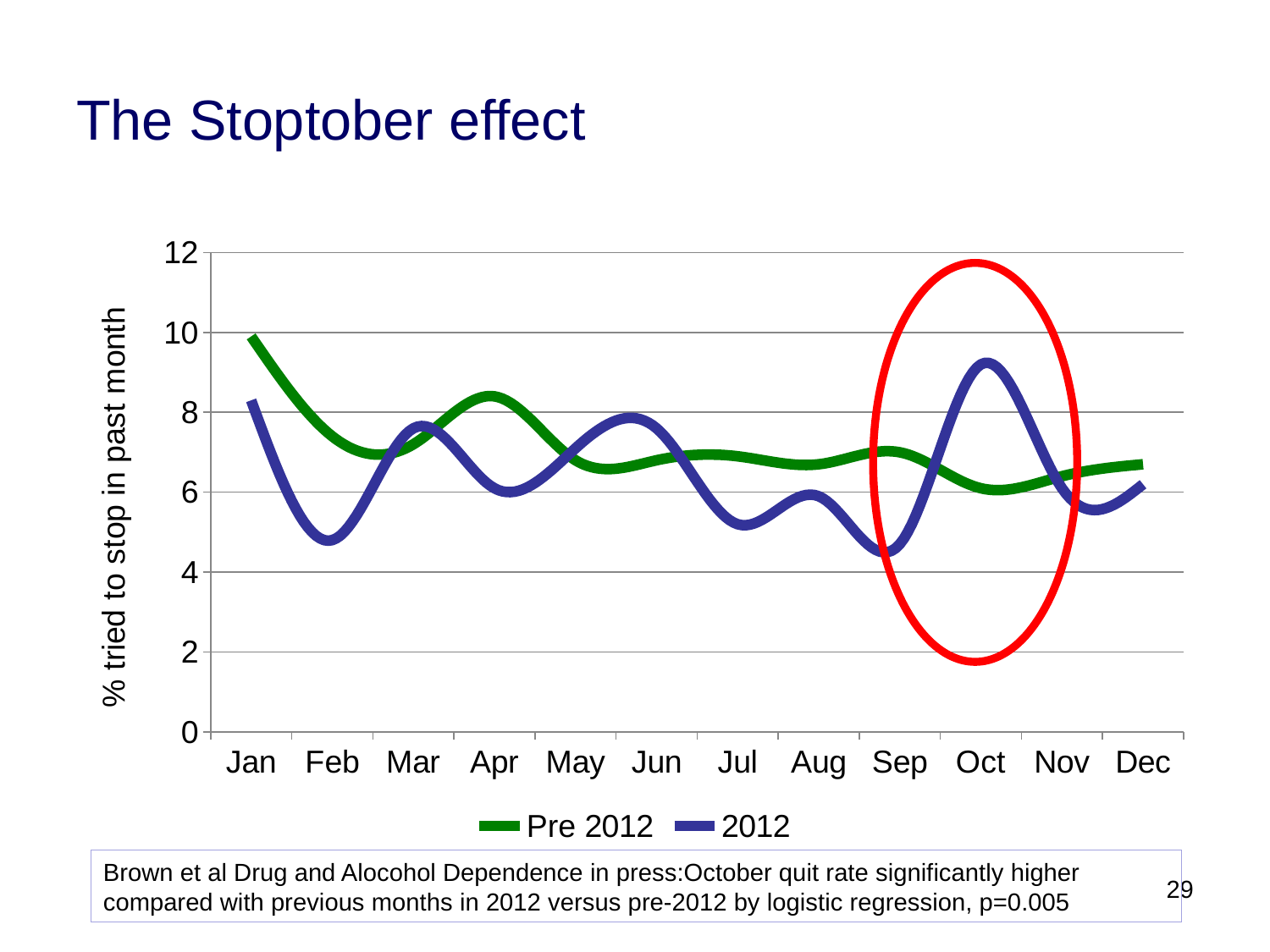
In Oct, which series has the higher value, Pre 2012 or 2012? 2012 What kind of chart is shown on the slide? line chart Is the 2012 value for Sep greater or less than 6? less Which month has the highest value for the Pre 2012 series? Jan Which month has the highest value for the 2012 series? Oct Which month is highlighted by the red circle on the chart? Oct In Jan, which series has the higher value, Pre 2012 or 2012? Pre 2012 How many months are shown along the x axis? 12 Is the 2012 value for Feb greater or less than 6? less How many series does the legend list? 2 Is the 2012 value for Oct greater or less than 8? greater